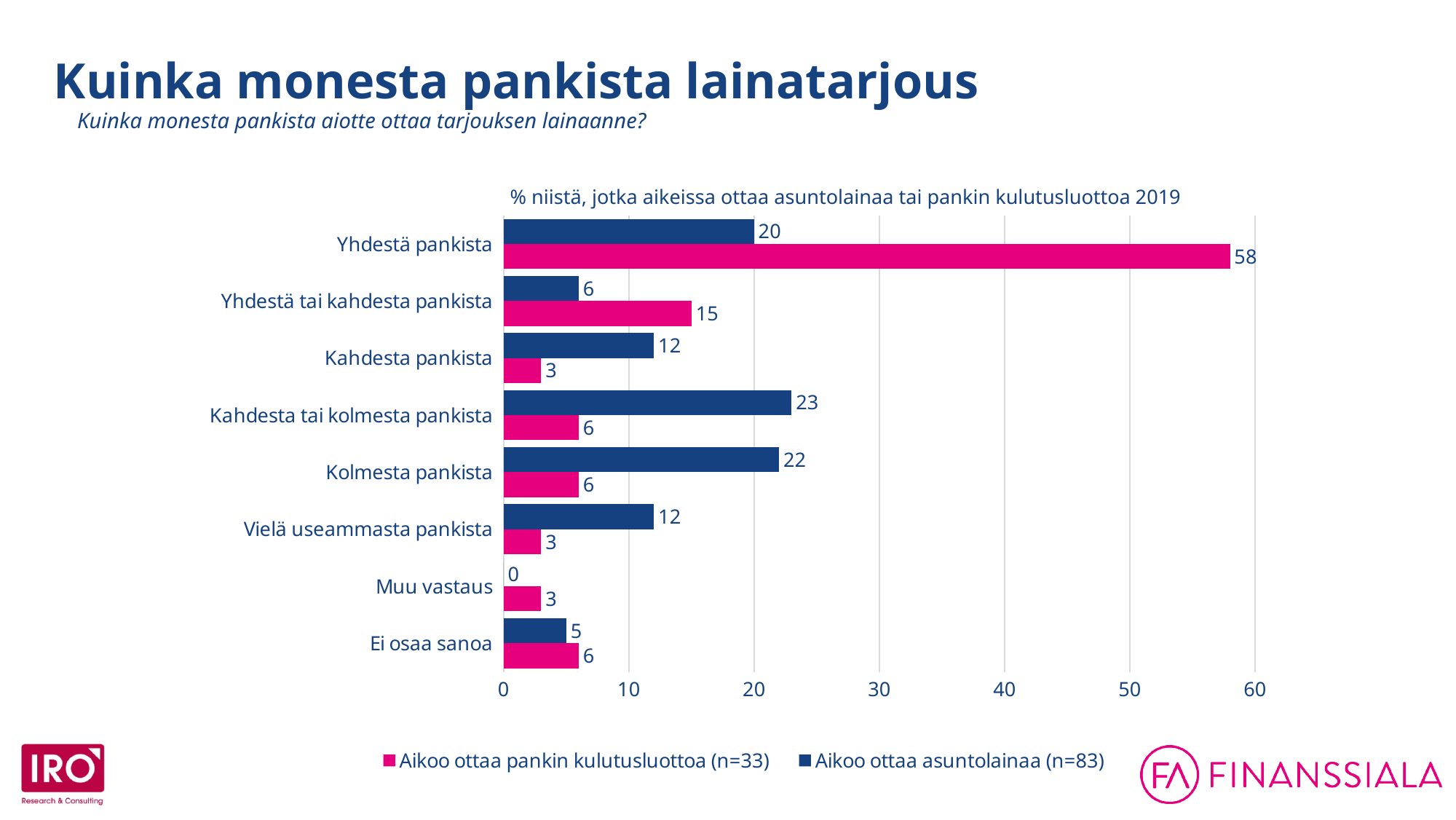
What is the value for "Muu vastaus" in the "Aikoo ottaa asuntolainaa (n=83)" series? 0 Is the value for "Yhdestä pankista" in the "Aikoo ottaa pankin kulutusluottoa (n=33)" series greater or less than 50? greater How many series does the legend list? 2 Which category has the highest value in the "Aikoo ottaa asuntolainaa (n=83)" series? Kahdesta tai kolmesta pankista What is the difference between the two series' values for "Yhdestä pankista"? 38 What is the value for "Yhdestä pankista" in the "Aikoo ottaa pankin kulutusluottoa (n=33)" series? 58 What is the value for "Kahdesta tai kolmesta pankista" in the "Aikoo ottaa asuntolainaa (n=83)" series? 23 How many categories are shown on the chart? 8 What colour are the bars for the "Aikoo ottaa pankin kulutusluottoa (n=33)" series? Pink What kind of chart is shown on the slide? Bar chart For "Kahdesta pankista", which series has the larger value? Aikoo ottaa asuntolainaa (n=83) Which category has the lowest value in the "Aikoo ottaa asuntolainaa (n=83)" series? Muu vastaus